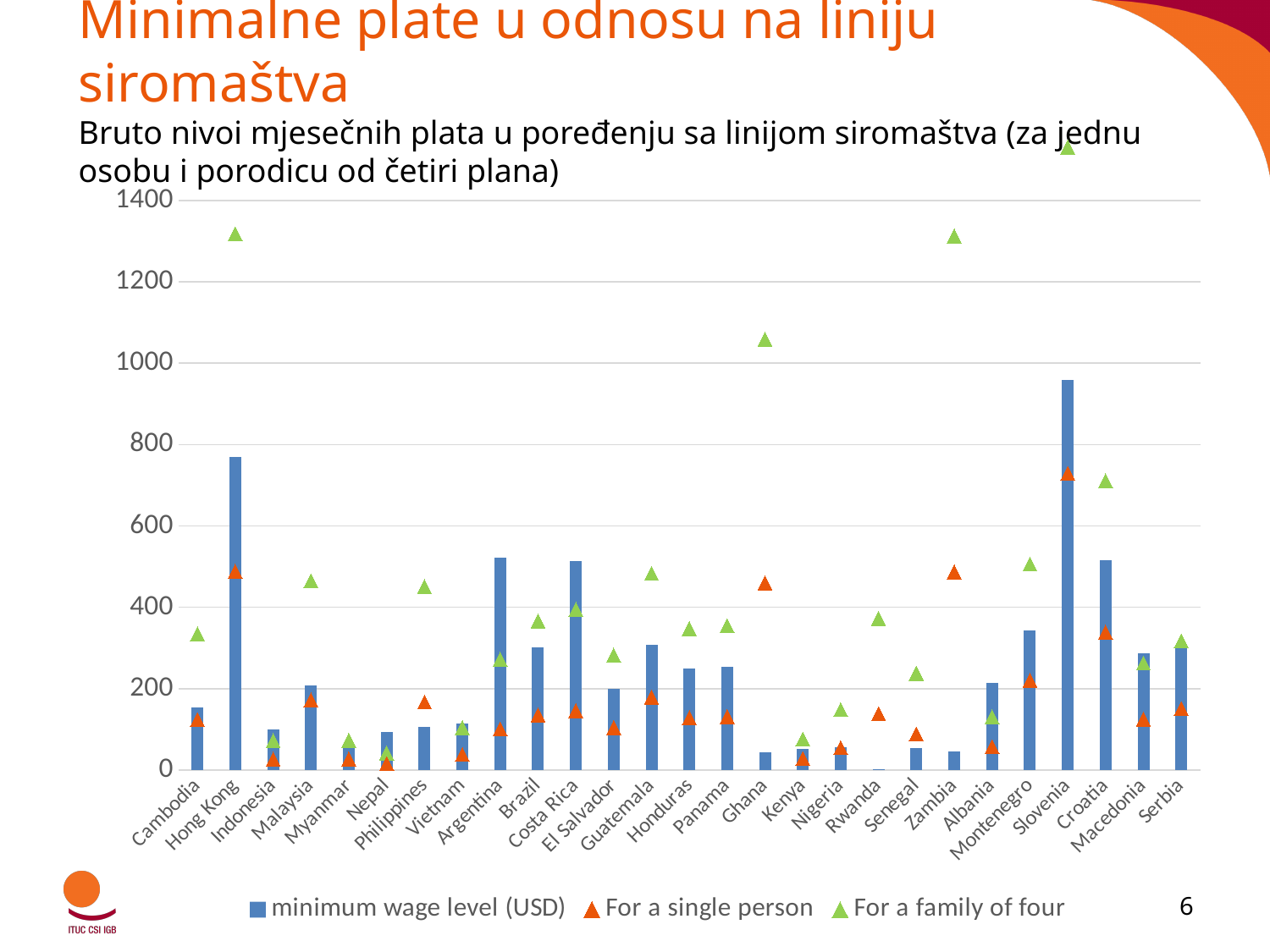
How many series does the chart legend list? 3 Which country has the highest minimum wage level (USD) bar? Slovenia How many countries are shown on the x axis of the chart? 27 Is the 'For a family of four' value for Ghana greater or less than 800? greater Is the minimum wage level (USD) for Slovenia greater or less than 800? greater Is the minimum wage level (USD) for Hong Kong greater or less than 600? greater Which country has the lowest minimum wage level (USD) bar? Rwanda Which has a larger minimum wage level (USD) bar, Hong Kong or Argentina? Hong Kong What colour are the 'For a family of four' markers in the chart? Green Which has a larger minimum wage level (USD) bar, Slovenia or Croatia? Slovenia